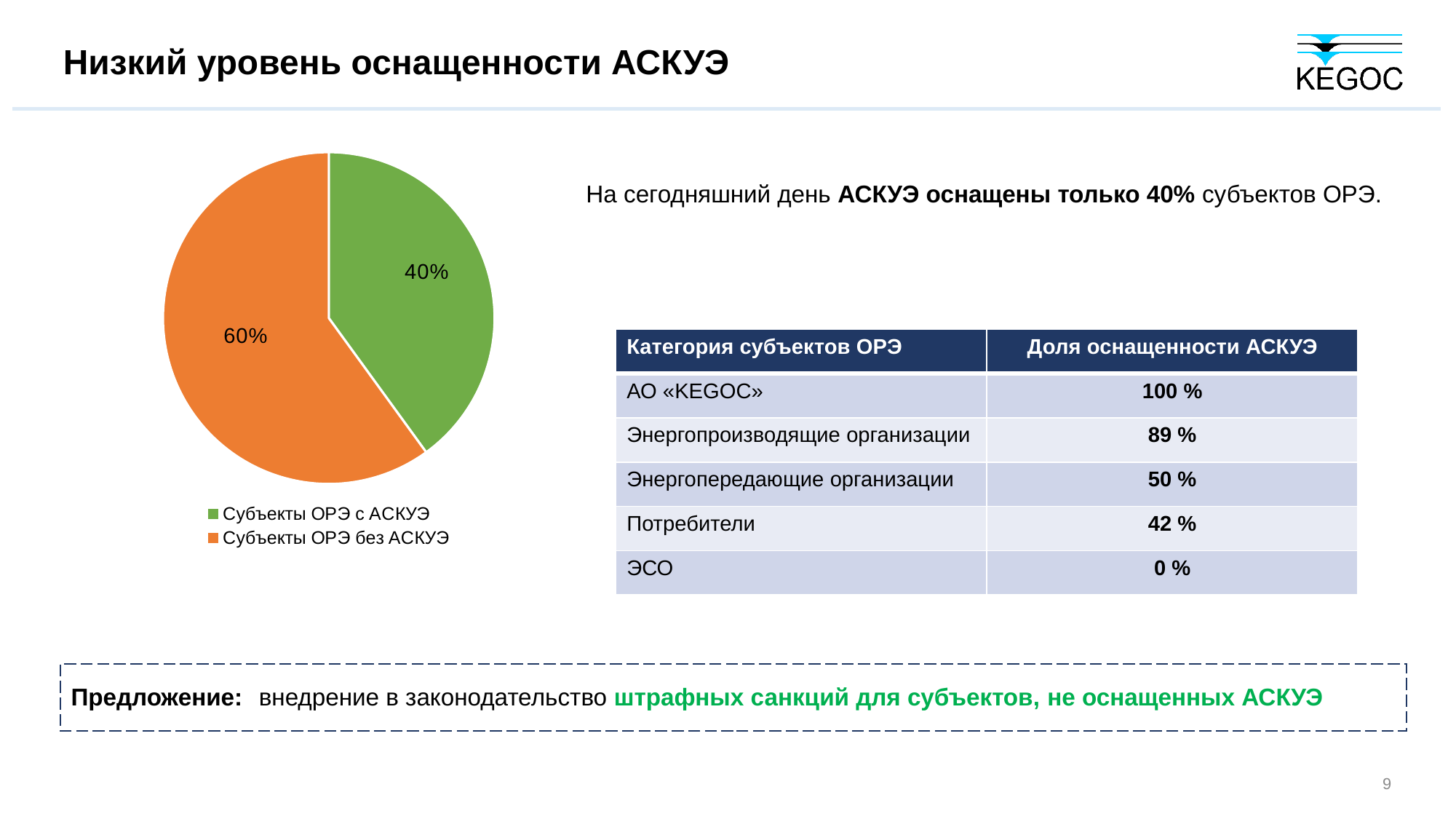
Which slice of the pie is the smallest? Субъекты ОРЭ с АСКУЭ What kind of chart is shown on the slide? pie chart Which slice of the pie is the largest? Субъекты ОРЭ без АСКУЭ How many entries does the legend of the pie chart list? 2 What colour is the slice for "Субъекты ОРЭ с АСКУЭ"? green What share of the pie is labelled "Субъекты ОРЭ с АСКУЭ"? 40% Which is larger: the share of "Субъекты ОРЭ с АСКУЭ" or the share of "Субъекты ОРЭ без АСКУЭ"? Субъекты ОРЭ без АСКУЭ What is the difference in percentage points between the "Субъекты ОРЭ без АСКУЭ" slice and the "Субъекты ОРЭ с АСКУЭ" slice? 20% How many slices does the pie chart have? 2 What share of the pie is labelled "Субъекты ОРЭ без АСКУЭ"? 60% What colour is the slice for "Субъекты ОРЭ без АСКУЭ"? orange